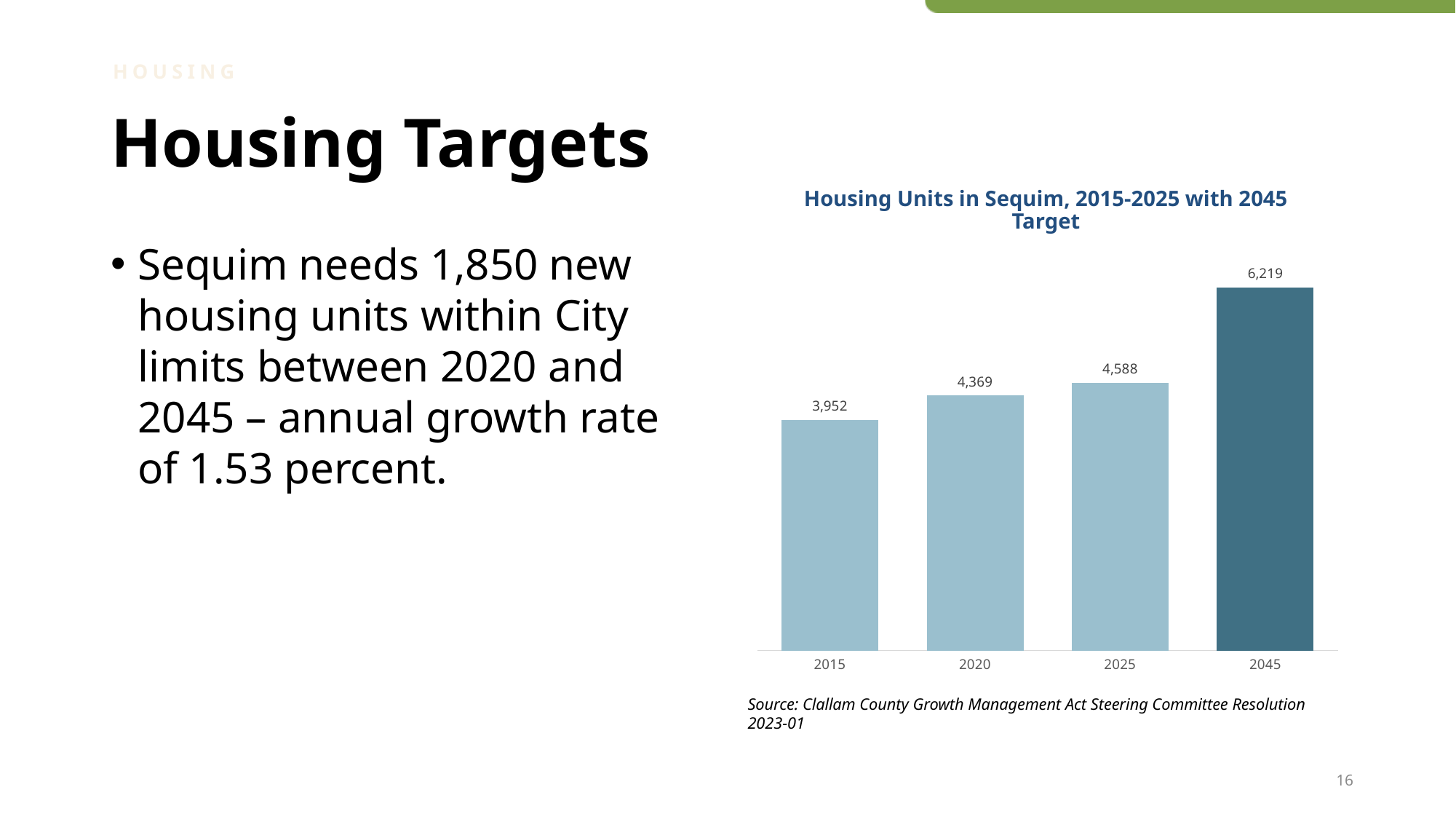
What is the number of housing units in Sequim for 2025? 4,588 How many years (bars) are shown on the chart? 4 Which is larger, the housing units in 2020 or in 2025? 2025 Which year has the highest number of housing units on the chart? 2045 What kind of chart is shown on the slide? Bar chart What is the 2045 target for housing units in Sequim? 6,219 What is the difference in housing units between 2025 and 2015? 636 What is the difference between the 2045 target and the 2020 housing units? 1,850 What is the number of housing units in Sequim for 2020? 4,369 Which year has the lowest number of housing units on the chart? 2015 Do the housing unit values rise or fall from 2015 to 2045? Rise What is the number of housing units in Sequim for 2015? 3,952